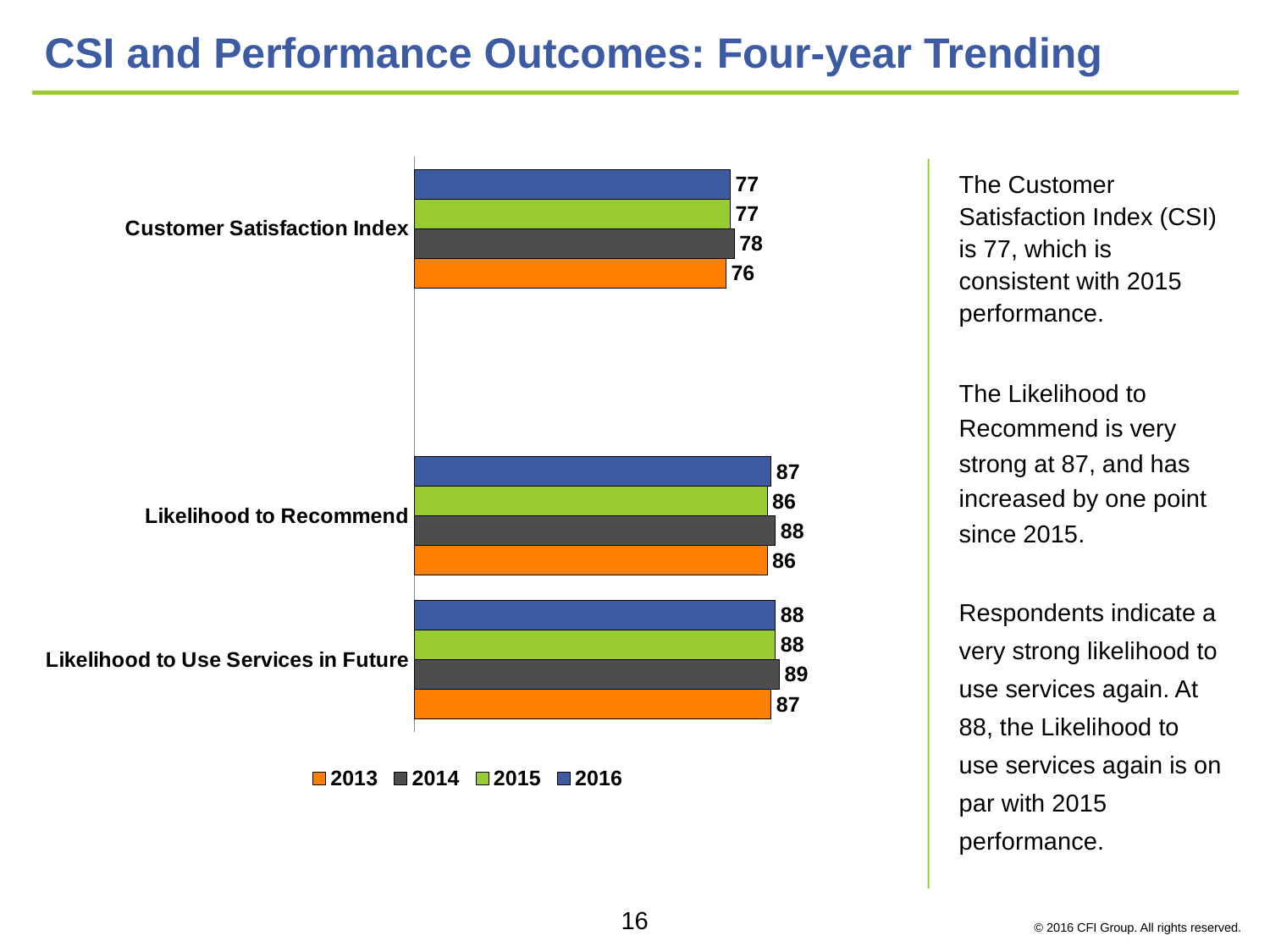
Which year has the highest value for Customer Satisfaction Index? 2014 Which year has the lowest value for Likelihood to Use Services in Future? 2013 What is the 2016 value for Customer Satisfaction Index? 77 What is the 2015 value for Likelihood to Recommend? 86 What is the difference between the 2016 and 2015 values for Likelihood to Recommend? 1 How many series does the legend list? 4 What kind of chart is shown on the slide? Bar chart How many categories are shown on the chart? 3 What is the difference between the 2014 and 2013 values for Customer Satisfaction Index? 2 Which is larger for 2016: Likelihood to Recommend or Likelihood to Use Services in Future? Likelihood to Use Services in Future What is the 2013 value for Likelihood to Recommend? 86 What is the 2014 value for Likelihood to Use Services in Future? 89